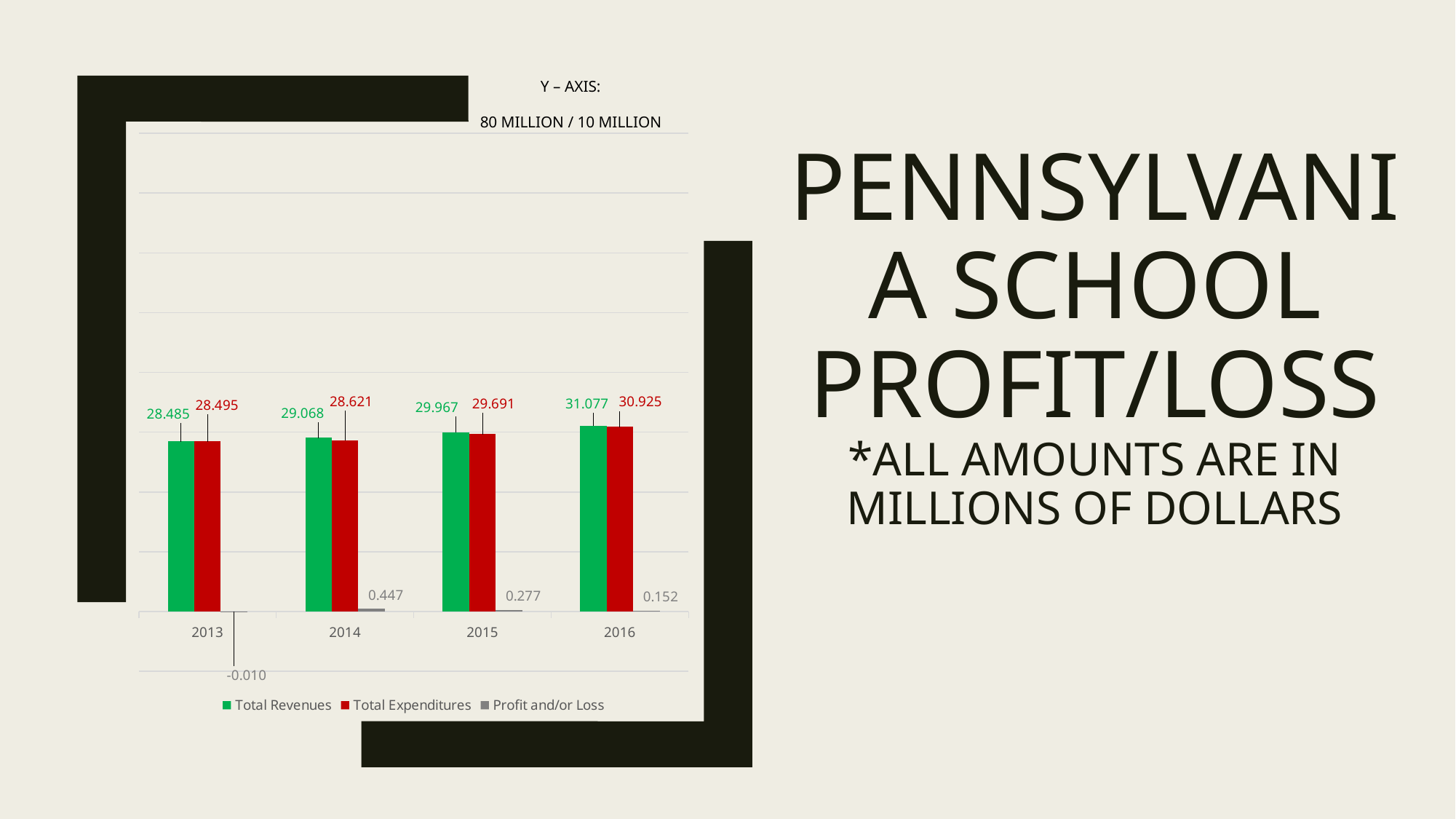
Which year has the lowest Profit and/or Loss? 2013 What is the Total Expenditures value for 2014? 28.621 Which year has the highest Total Revenues? 2016 Do Total Revenues rise or fall from 2013 to 2016? rise Is Total Revenues larger in 2016 or in 2013? 2016 What is the Total Revenues value for 2015? 29.967 What is the difference between Total Revenues and Total Expenditures in 2016? 0.152 How many series does the legend list? 3 What is the Profit and/or Loss value for 2016? 0.152 Which year has the highest Profit and/or Loss? 2014 What is the Profit and/or Loss value for 2013? -0.010 How many years are shown on the x axis? 4